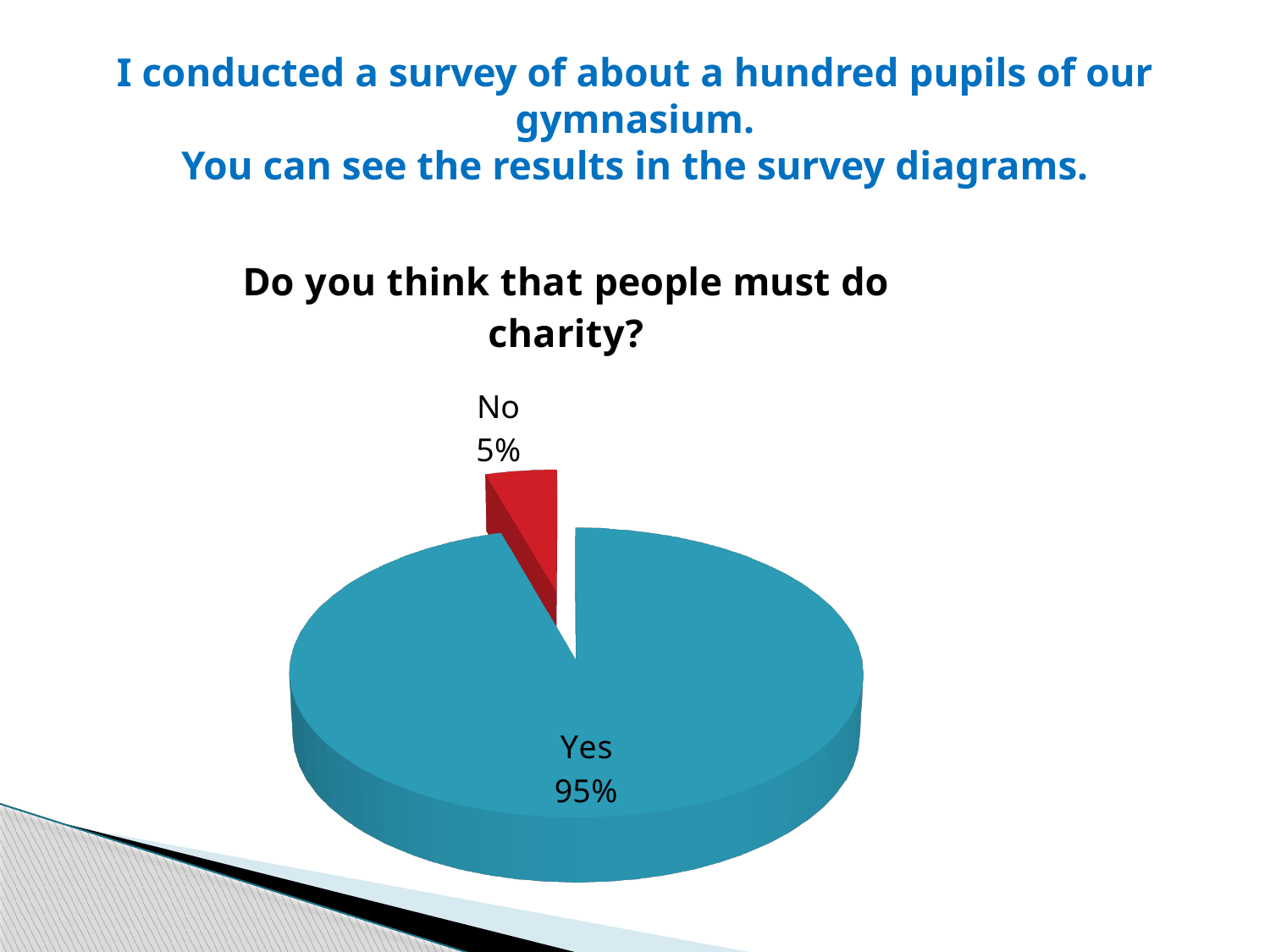
What share of the pie does the "No" slice represent? 5% Which answer has the largest share of the pie? Yes Which answer has the smallest share of the pie? No What percentage of pupils answered "Yes" to whether people must do charity? 95% What percentage of pupils answered "No" to whether people must do charity? 5% What colour is the "No" slice of the pie? Red What is the title of the chart? Do you think that people must do charity? Which is larger, the share for "Yes" or the share for "No"? Yes What is the difference in percentage points between the "Yes" and "No" shares? 90 How many slices does the pie chart have? 2 What kind of chart is shown on the slide? Pie chart